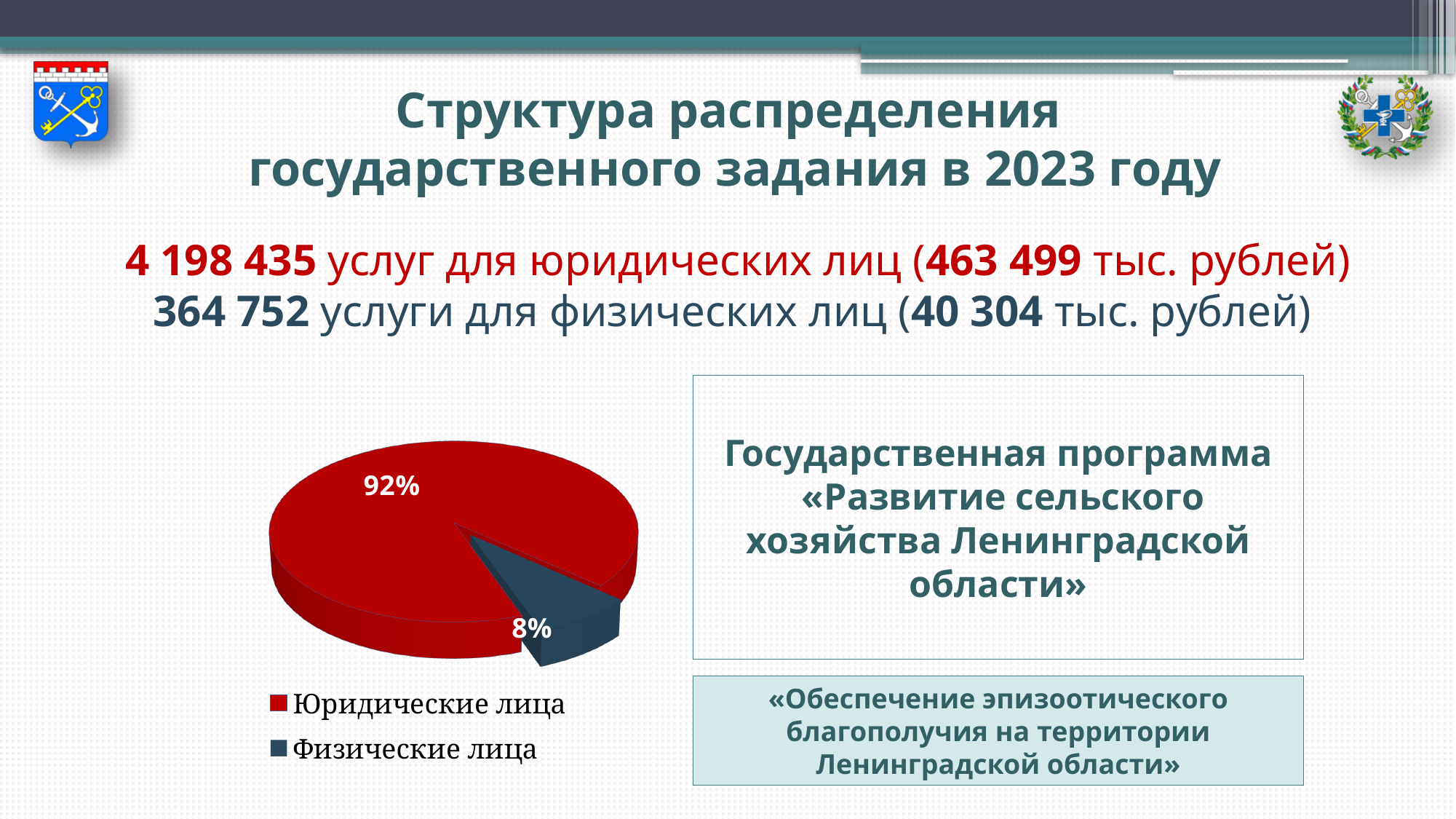
Which category has the largest slice of the pie? Юридические лица What share of the pie does Физические лица have? 8% What colour is the Юридические лица slice? red How many slices does the pie chart have? 2 How many entries does the legend list? 2 What kind of chart is shown on the slide? pie chart What share of the pie does Юридические лица have? 92% What colour is the Физические лица slice? dark blue-grey What is the difference in percentage points between the Юридические лица slice and the Физические лица slice? 84 Which category has the smallest slice of the pie? Физические лица Which slice is larger, Юридические лица or Физические лица? Юридические лица